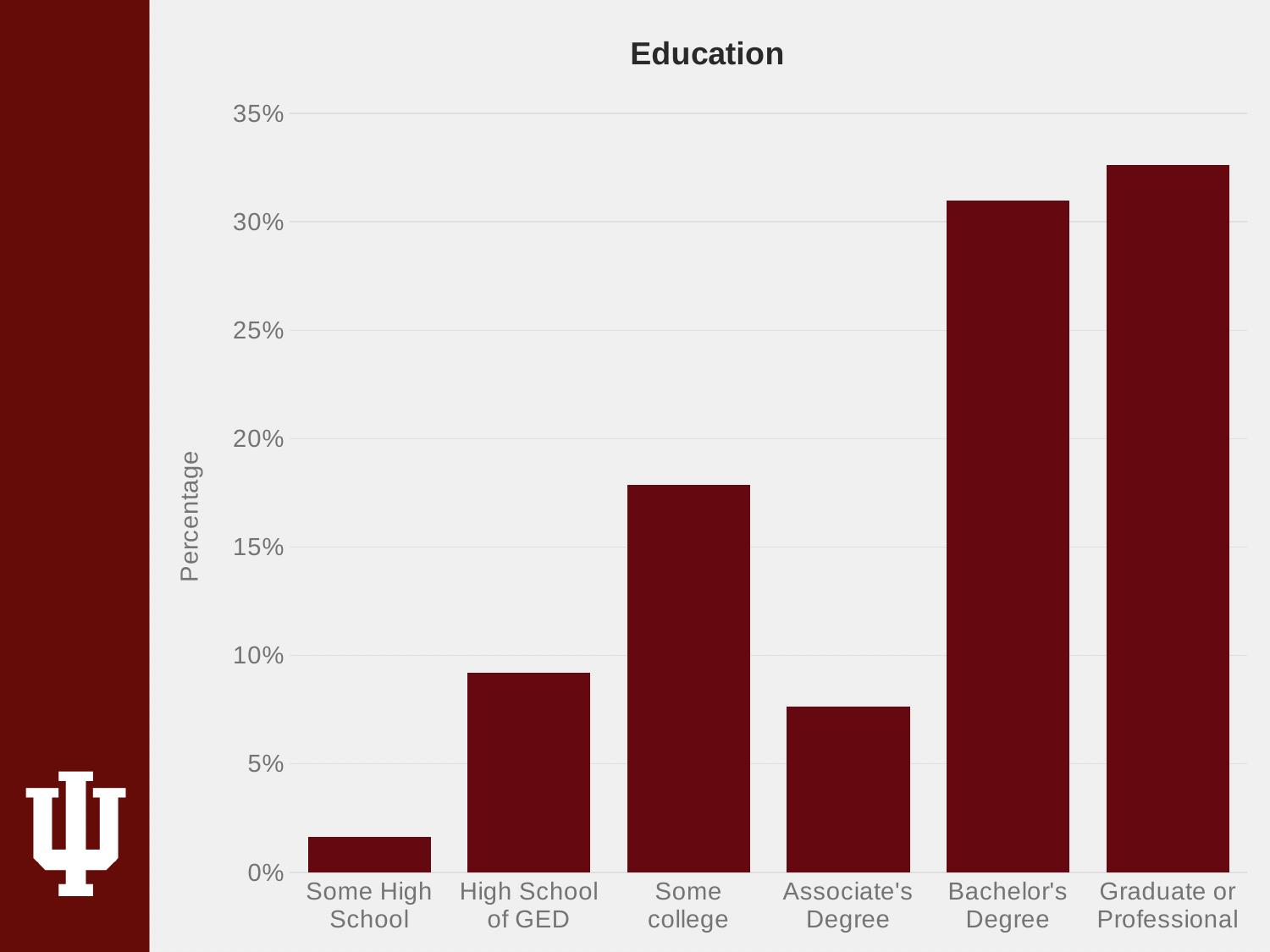
What is the title of the chart? Education Which is larger, the value for Some college or the value for Associate's Degree? Some college What kind of chart is shown on the slide? bar chart Which education category has the highest percentage? Graduate or Professional Is the value for Some High School greater or less than 5%? less What is the label on the vertical axis of the chart? Percentage Is the value for Associate's Degree greater or less than 10%? less Is the value for Some college greater or less than 15%? greater Which education category has the lowest percentage? Some High School How many education categories are shown on the x axis? 6 Which is larger, the value for High School of GED or the value for Associate's Degree? High School of GED